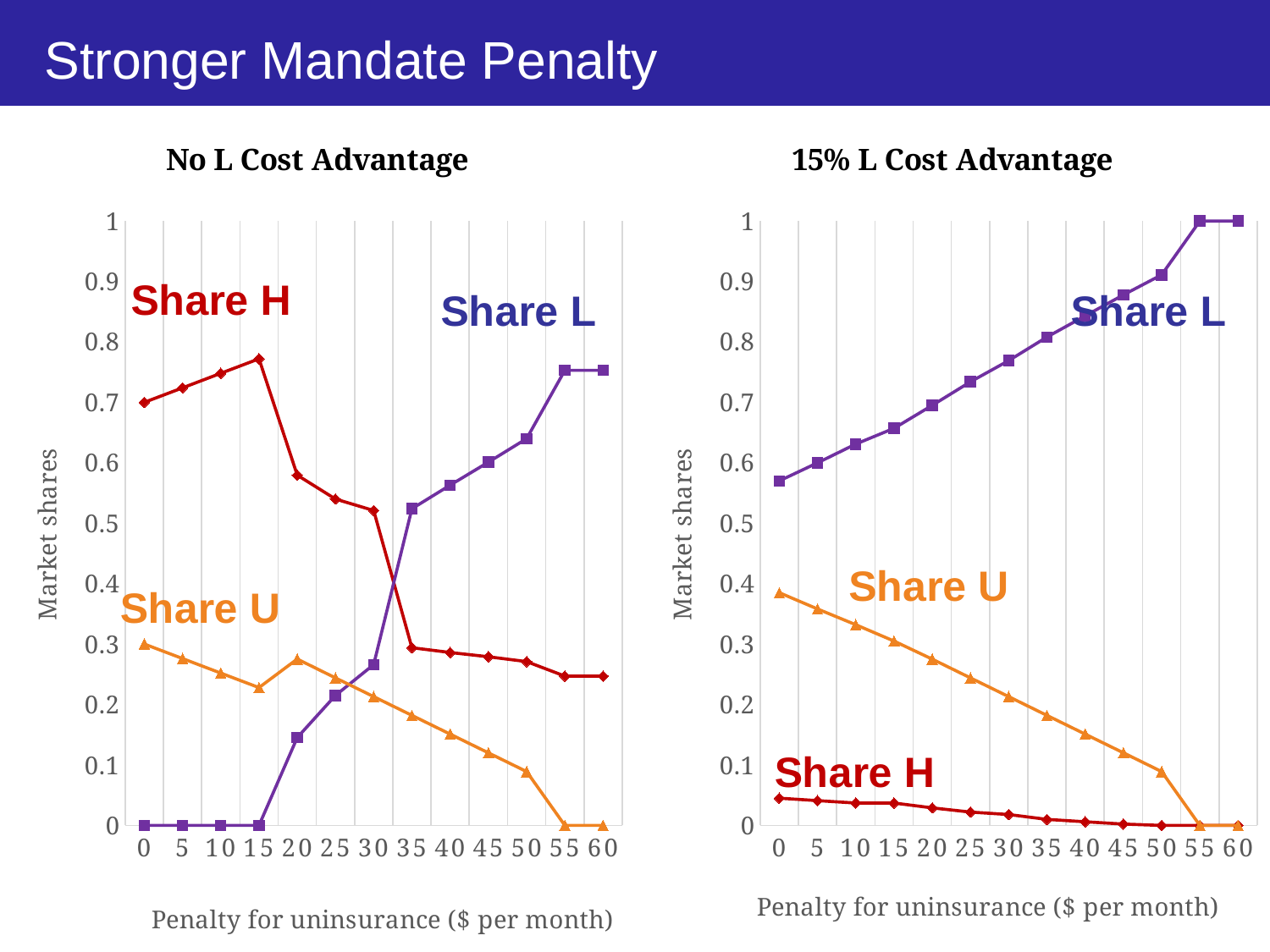
In the 'No L Cost Advantage' chart, which is larger at a penalty of 60: Share L or Share H? Share L In the 'No L Cost Advantage' chart, what is the value of Share L at a penalty of 0? 0 In the 'No L Cost Advantage' chart, is the value of Share H at a penalty of 15 greater or less than 0.7? greater How many penalty values are plotted along the x axis of the 'No L Cost Advantage' chart? 13 In the '15% L Cost Advantage' chart, does Share U rise or fall as the penalty increases? fall What kind of chart is the 'No L Cost Advantage' chart? line chart In the '15% L Cost Advantage' chart, which series has the highest value at a penalty of 0? Share L In the '15% L Cost Advantage' chart, what is the value of Share L at a penalty of 60? 1 In the 'No L Cost Advantage' chart, what is the value of Share U at a penalty of 60? 0 In the '15% L Cost Advantage' chart, which series has the lowest value at a penalty of 30? Share H In the '15% L Cost Advantage' chart, is the value of Share L at a penalty of 0 greater or less than 0.5? greater How many series are plotted in the '15% L Cost Advantage' chart? 3